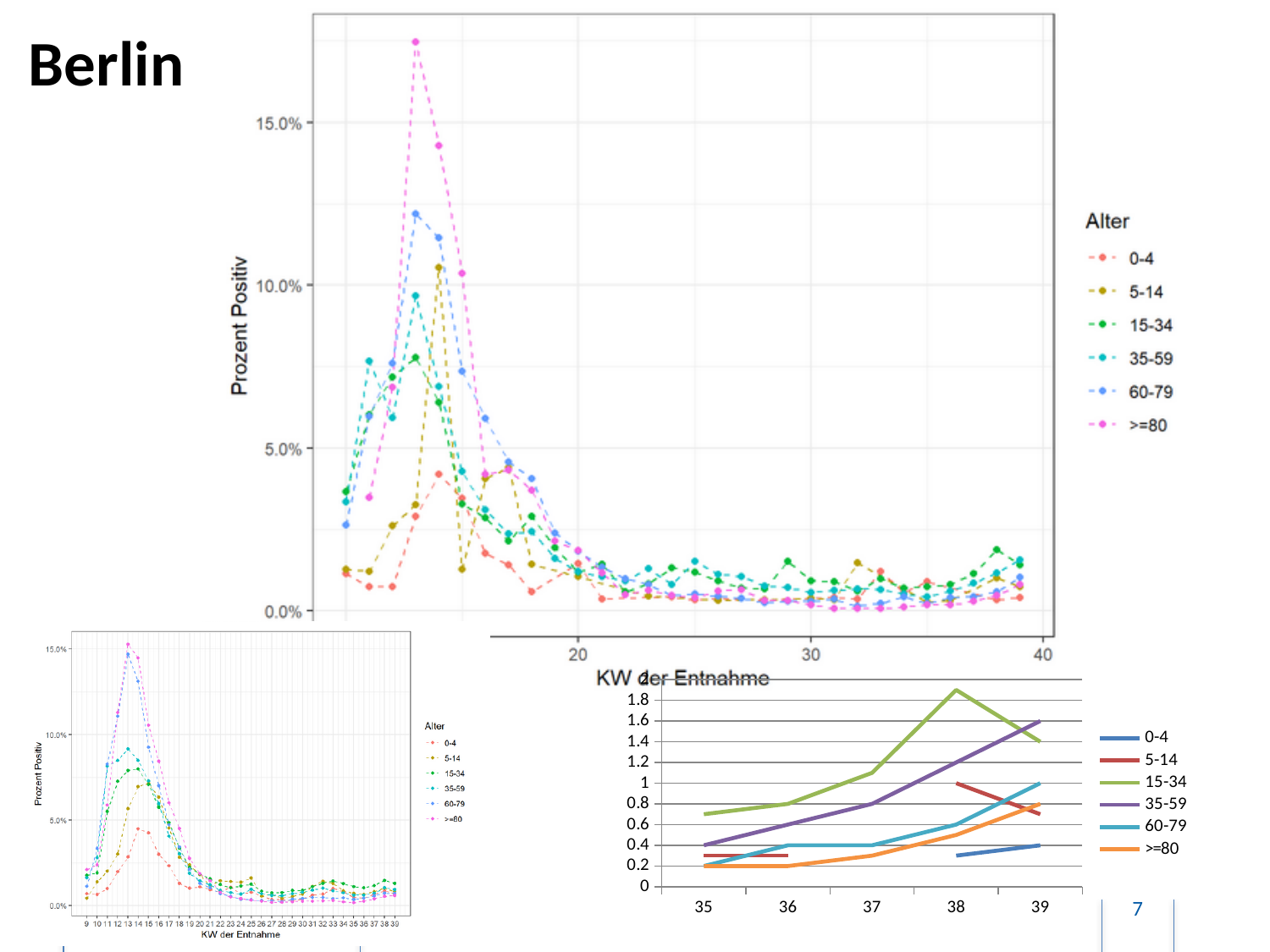
In the bottom-right chart, which is larger at 39: 35-59 or 60-79? 35-59 In the large top chart, is the peak value for the 60-79 series greater or less than 10.0%? greater In the bottom-right chart, which series reaches the highest value? 15-34 In the large top chart, which age group reaches the highest percentage positive? >=80 In the bottom-right chart, how many points are shown on the x axis? 5 In the bottom-right chart, is the value for 15-34 at 38 greater or less than 1.6? greater In the bottom-right chart, how many series does the legend list? 6 In the bottom-right chart, is the value for 5-14 at 38 greater or less than 0.8? greater In the bottom-right chart, does the 35-59 series rise or fall from 35 to 39? rise What is the title of the legend in the large top chart? Alter What kind of chart is the bottom-right chart? line chart